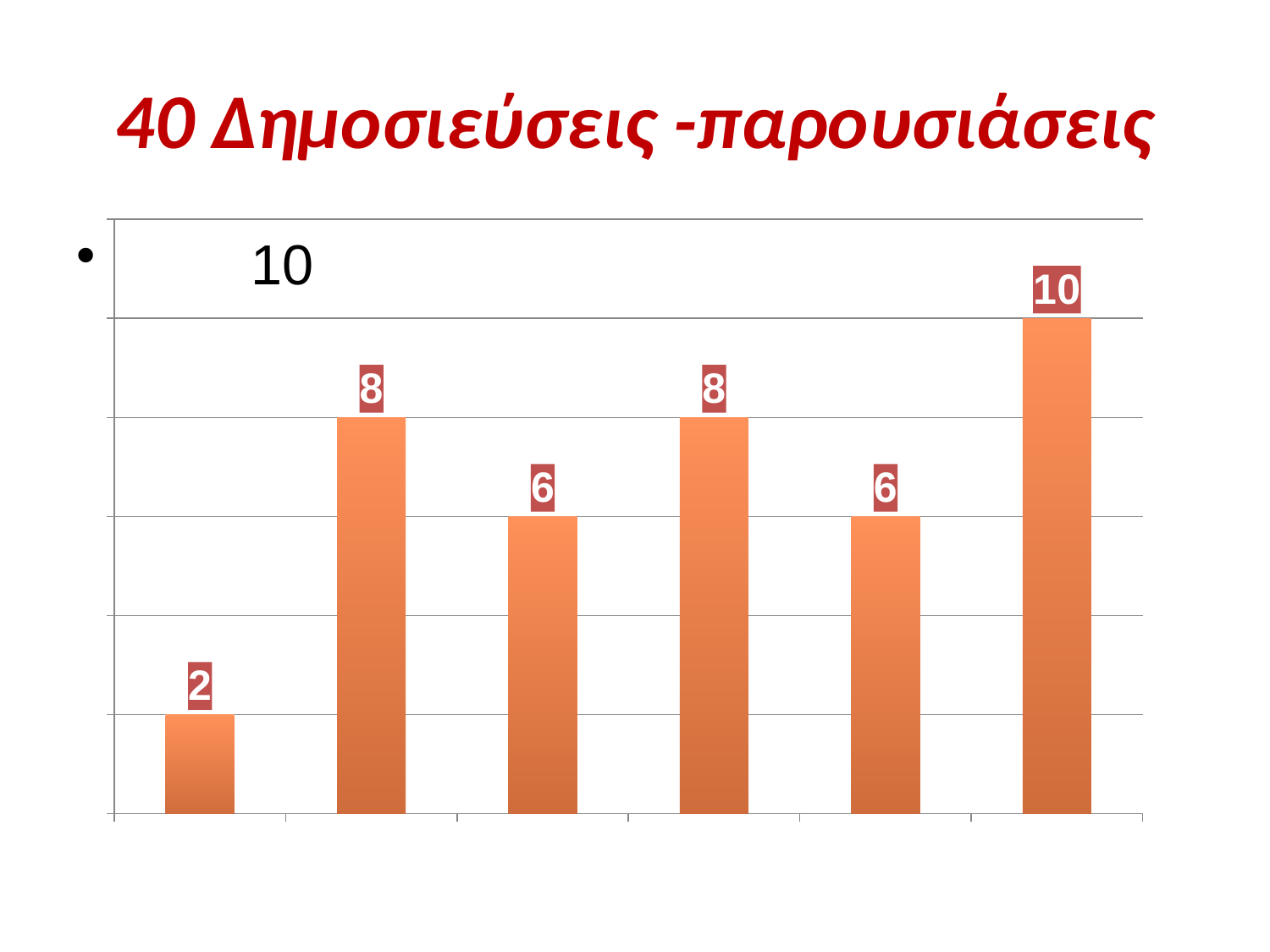
What is the value of the third bar from the left? 6 What is the sum of the values of all six bars? 40 What is the value of the first (leftmost) bar? 2 How many bars does the chart contain? 6 What is the difference between the rightmost bar and the leftmost bar? 8 What is the value of the last (rightmost) bar? 10 What is the title of the slide containing the chart? 40 Δημοσιεύσεις -παρουσιάσεις What is the lowest value shown on any bar? 2 Which is larger, the second bar from the left or the third bar from the left? the second bar What is the value of the second bar from the left? 8 What kind of chart is shown on the slide? bar chart What is the highest value shown on any bar? 10